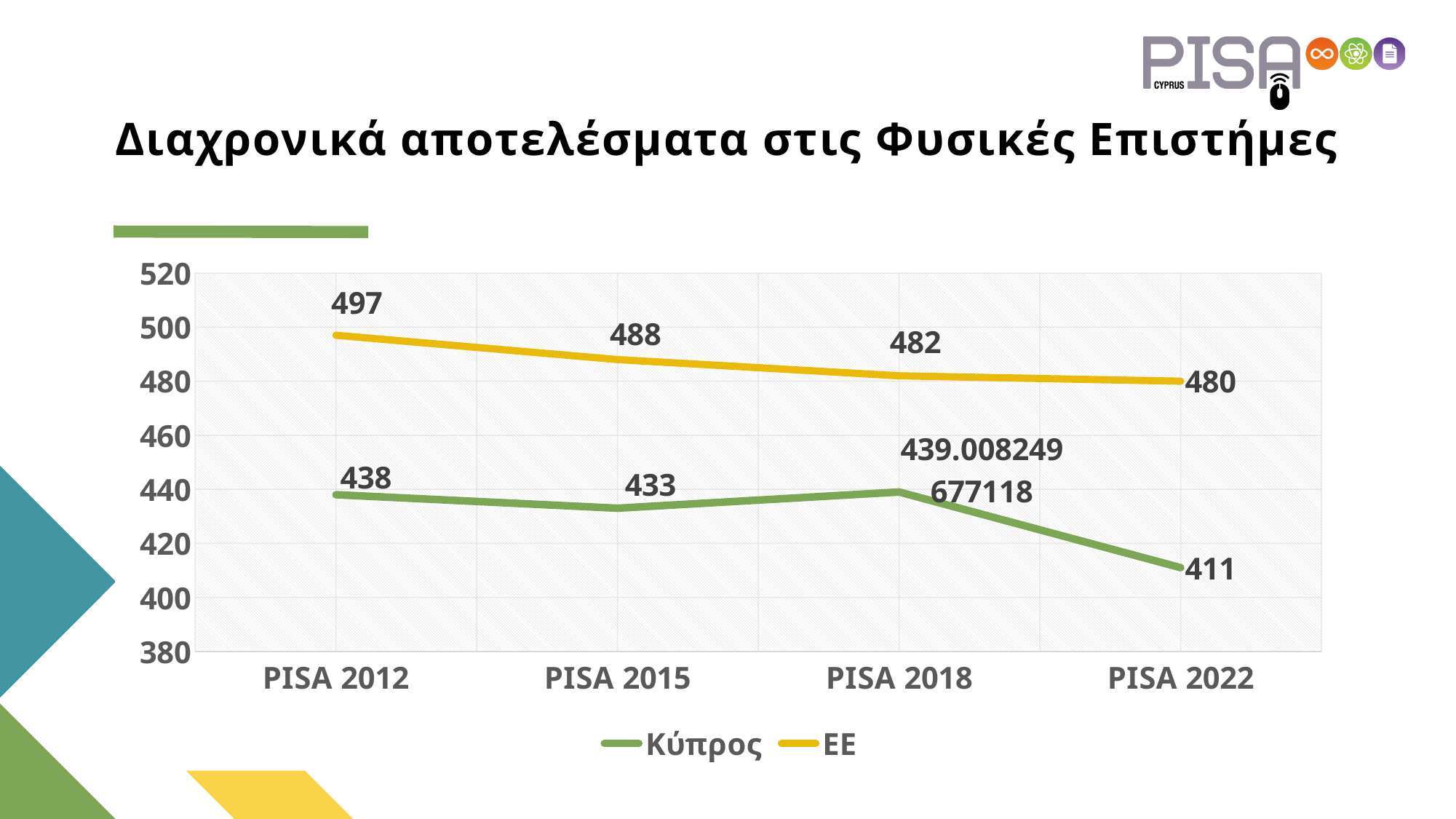
What is the value for ΕΕ at PISA 2018? 482 What kind of chart is shown on the slide? line chart In which PISA cycle does ΕΕ have its highest value? PISA 2012 In which PISA cycle does Κύπρος have its lowest value? PISA 2022 What is the value for ΕΕ at PISA 2012? 497 How many PISA cycles are shown on the x axis? 4 Which series has the larger value at PISA 2015, Κύπρος or ΕΕ? ΕΕ What is the difference between the ΕΕ and Κύπρος values at PISA 2022? 69 Is the value for Κύπρος at PISA 2018 greater or less than 420? greater What is the value for Κύπρος at PISA 2022? 411 How many series does the legend list? 2 What is the value for Κύπρος at PISA 2015? 433